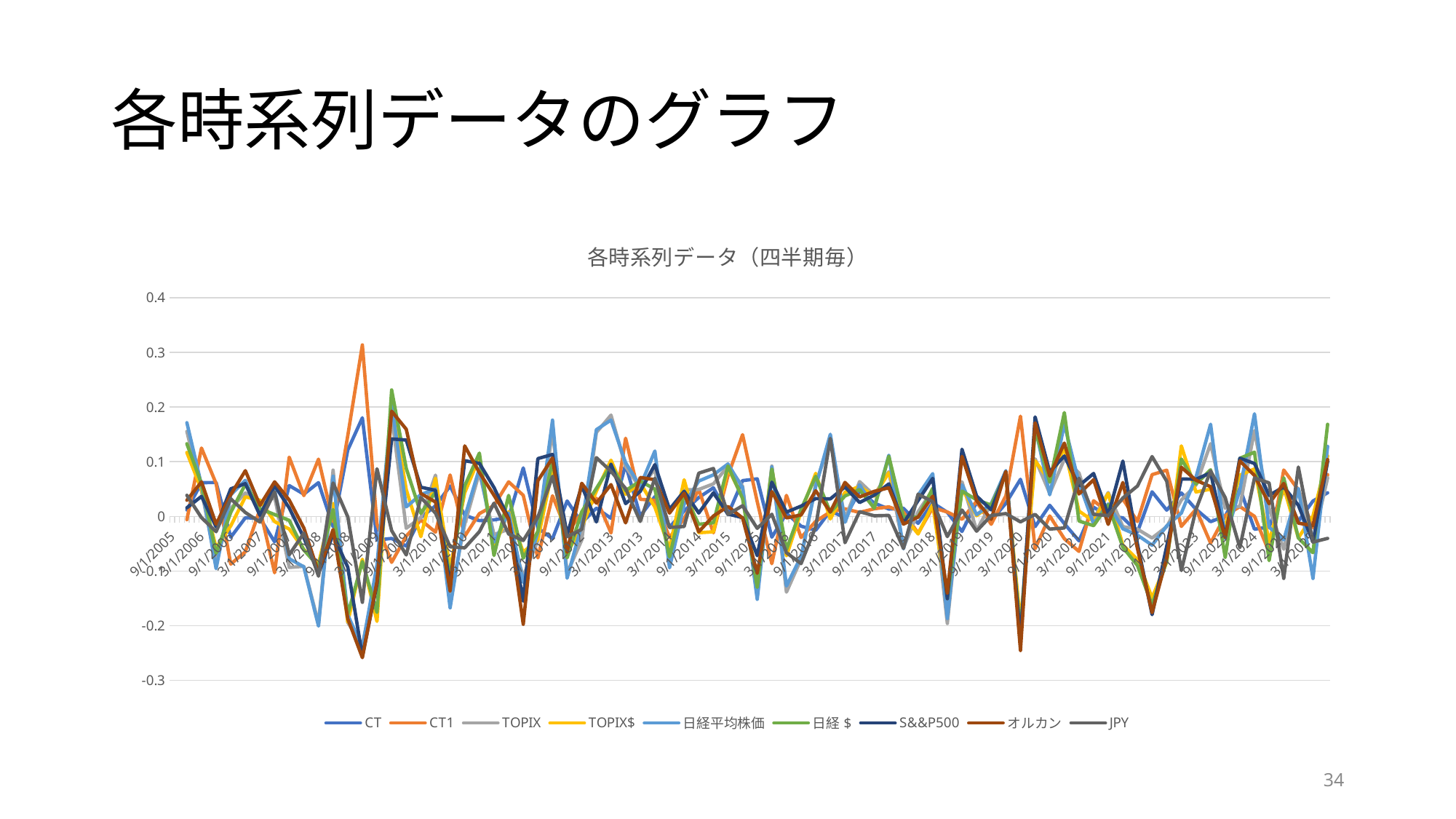
What is the title of the chart? 各時系列データ（四半期毎） Is the lowest point on the chart, around 3/1/2009, greater or less than -0.2? less What is the highest value shown on the chart's vertical axis? 0.4 What kind of chart is shown on the slide? line chart How many series does the legend of the chart list? 9 What is the lowest value shown on the chart's vertical axis? -0.3 What is the last date label on the chart's horizontal axis? 3/1/2025 Is the highest peak of the CT1 series, around 3/1/2009, greater or less than 0.2? greater Which series reaches the highest peak on the chart, around 3/1/2009? CT1 What is the first date label on the chart's horizontal axis? 9/1/2005 Which series is listed first in the chart's legend? CT